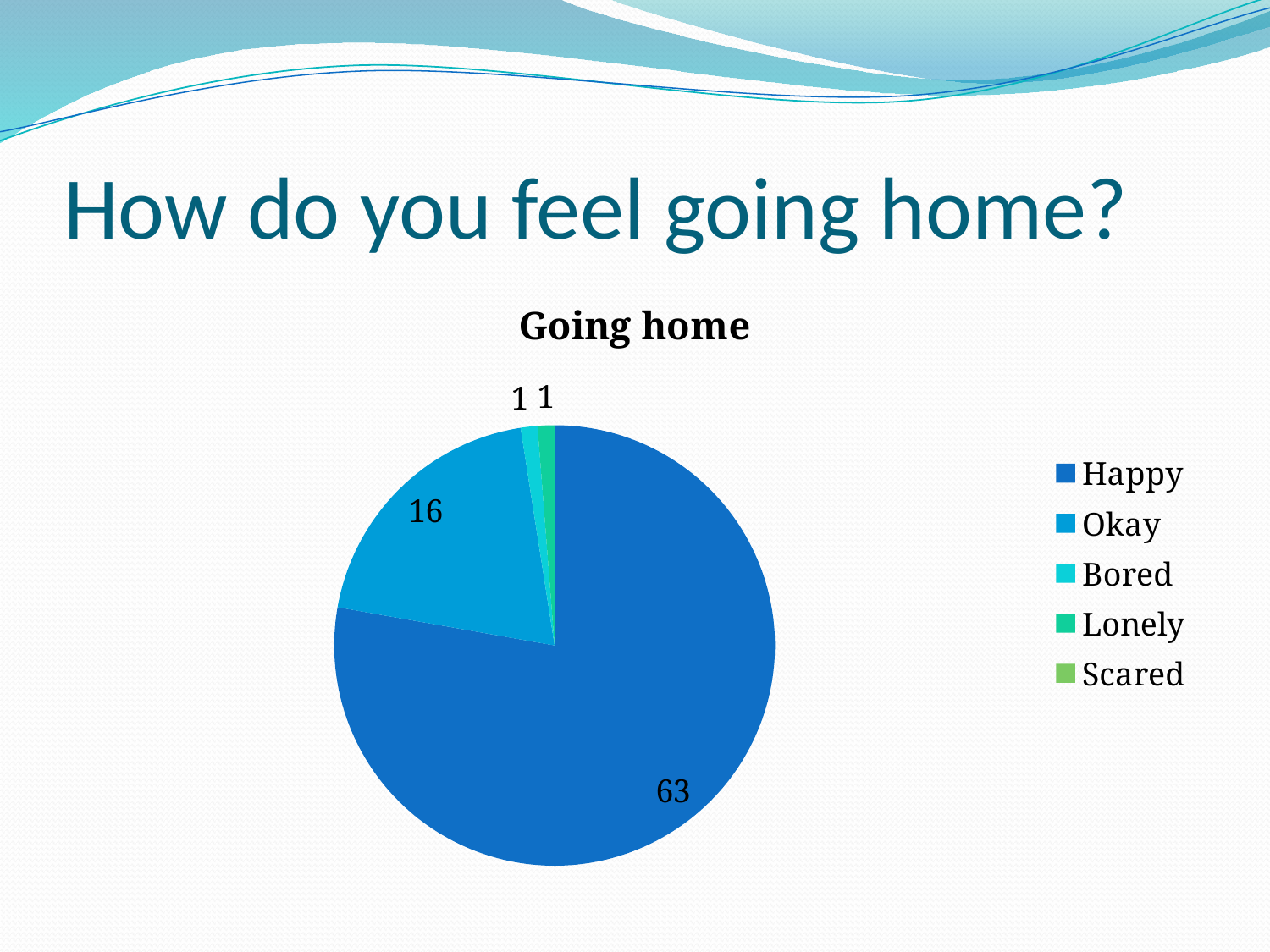
Which legend entry is listed last? Scared What type of chart is shown on the slide? pie chart Which category has the largest slice? Happy What is the value for Lonely? 1 What is the difference between the values for Happy and Okay? 47 What is the value for Okay? 16 What is the difference between the values for Okay and Lonely? 15 What is the value for Bored? 1 What is the chart's title? Going home How many entries does the legend list? 5 Which is larger, the value for Okay or the value for Bored? Okay What is the value for Happy? 63